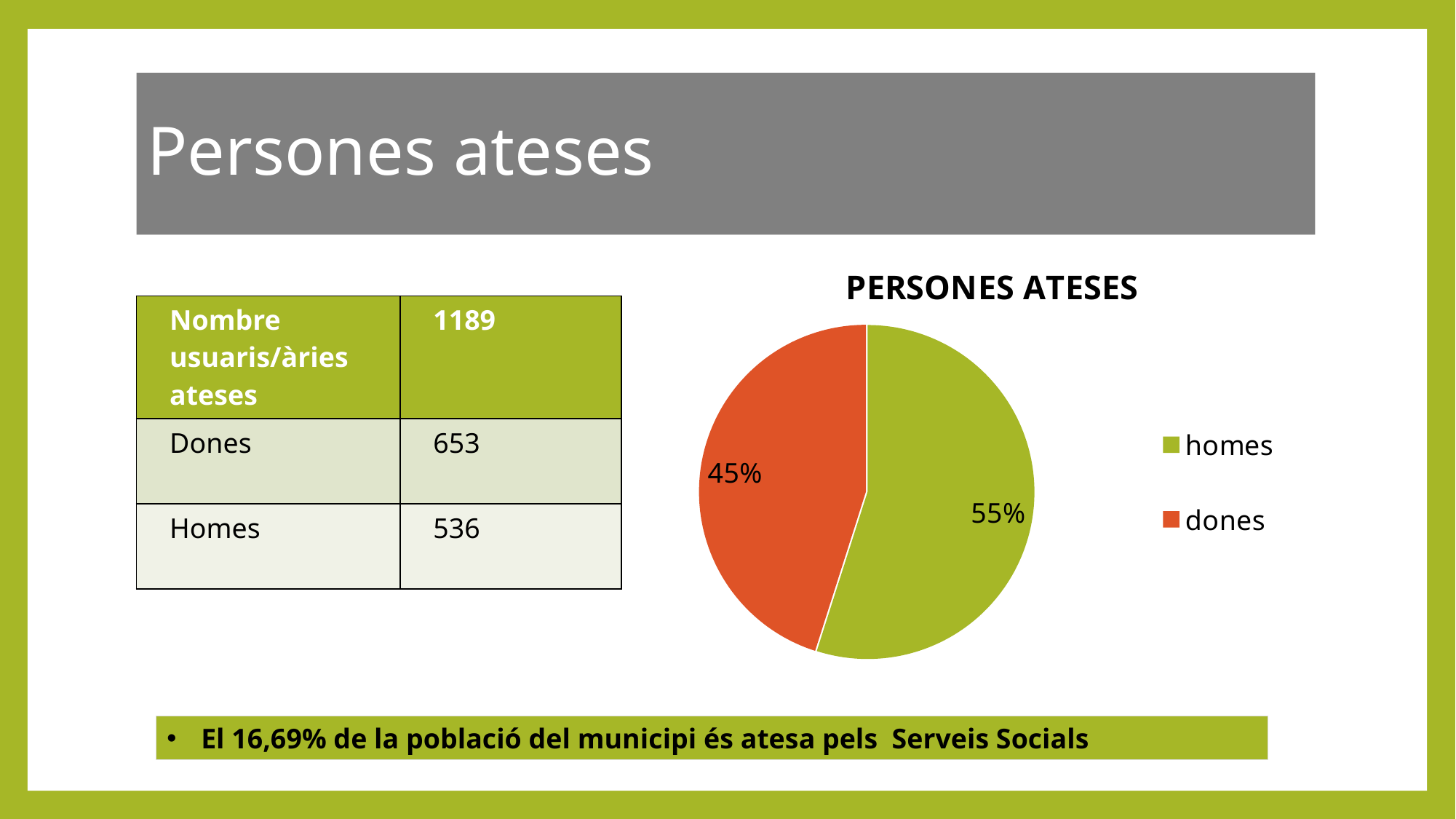
What kind of chart is shown on the slide? pie chart What colour is the 'dones' slice in the pie chart? orange Which slice is larger in the pie chart, 'homes' or 'dones'? homes What is the difference in percentage points between the 'homes' and 'dones' slices? 10 Which slice of the pie chart is the smallest? dones What is the title of the chart? PERSONES ATESES Is the share of the 'homes' slice greater or less than 50%? greater What percentage is shown for the 'homes' slice of the pie chart? 55% How many entries does the chart legend list? 2 What percentage is shown for the 'dones' slice of the pie chart? 45% Which slice of the pie chart is the largest? homes How many slices does the pie chart have? 2